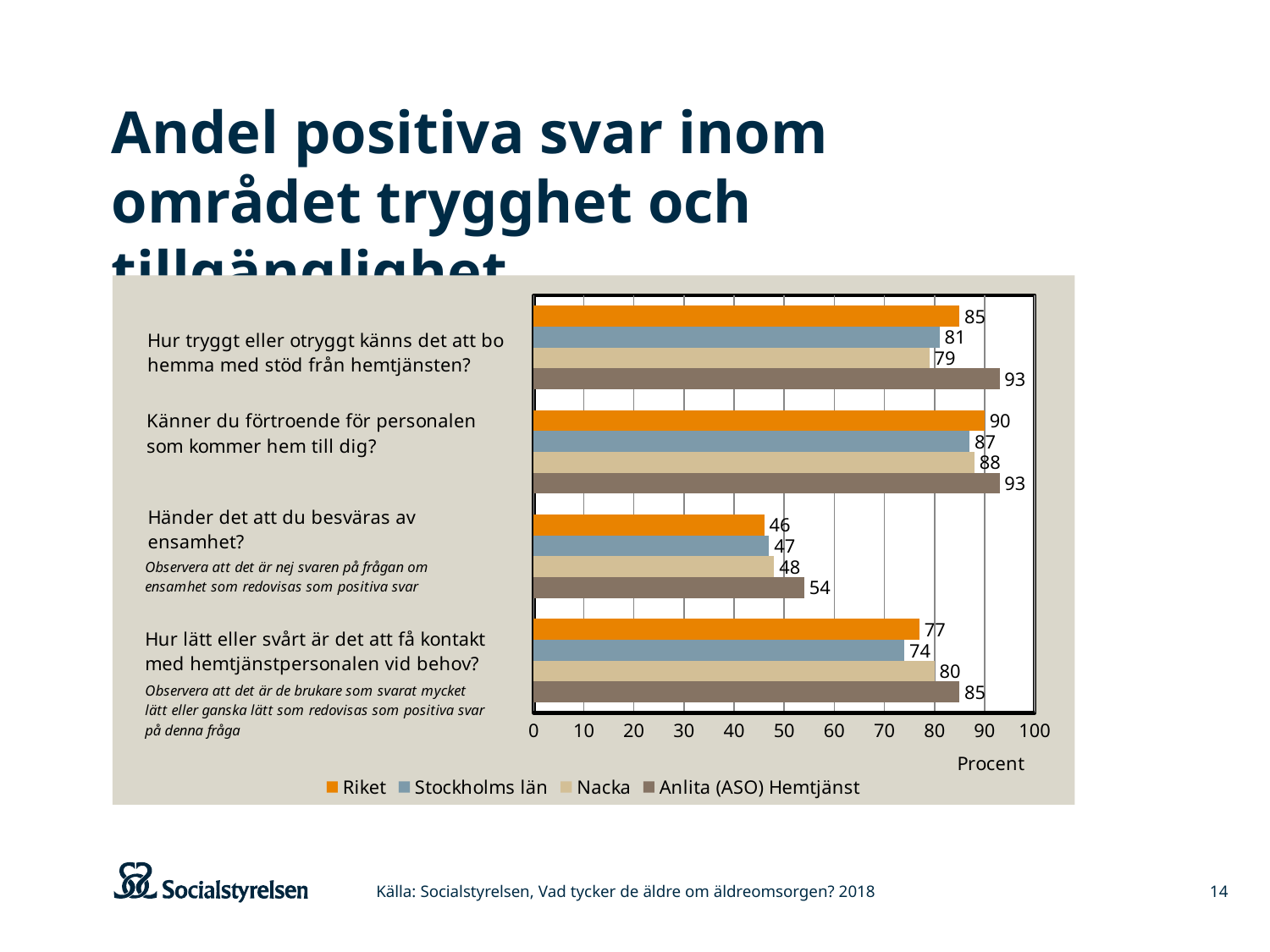
What is the difference between Anlita (ASO) Hemtjänst and Nacka on the question "Hur tryggt eller otryggt känns det att bo hemma med stöd från hemtjänsten?"? 14 Which is larger on the question "Känner du förtroende för personalen som kommer hem till dig?": Riket or Nacka? Riket What is the value for Riket on the question "Händer det att du besväras av ensamhet?"? 46 How many question categories are shown on the chart? 4 What kind of chart is shown on the slide? Bar chart Which series has the highest value on the question "Händer det att du besväras av ensamhet?"? Anlita (ASO) Hemtjänst What is the value for Stockholms län on the question "Hur tryggt eller otryggt känns det att bo hemma med stöd från hemtjänsten?"? 81 What is the value for Nacka on the question "Hur lätt eller svårt är det att få kontakt med hemtjänstpersonalen vid behov?"? 80 What is the value for Anlita (ASO) Hemtjänst on the question "Känner du förtroende för personalen som kommer hem till dig?"? 93 How many series does the legend list? 4 Which series has the lowest value on the question "Hur lätt eller svårt är det att få kontakt med hemtjänstpersonalen vid behov?"? Stockholms län Is the value for Anlita (ASO) Hemtjänst on the question "Händer det att du besväras av ensamhet?" greater or less than 50? greater